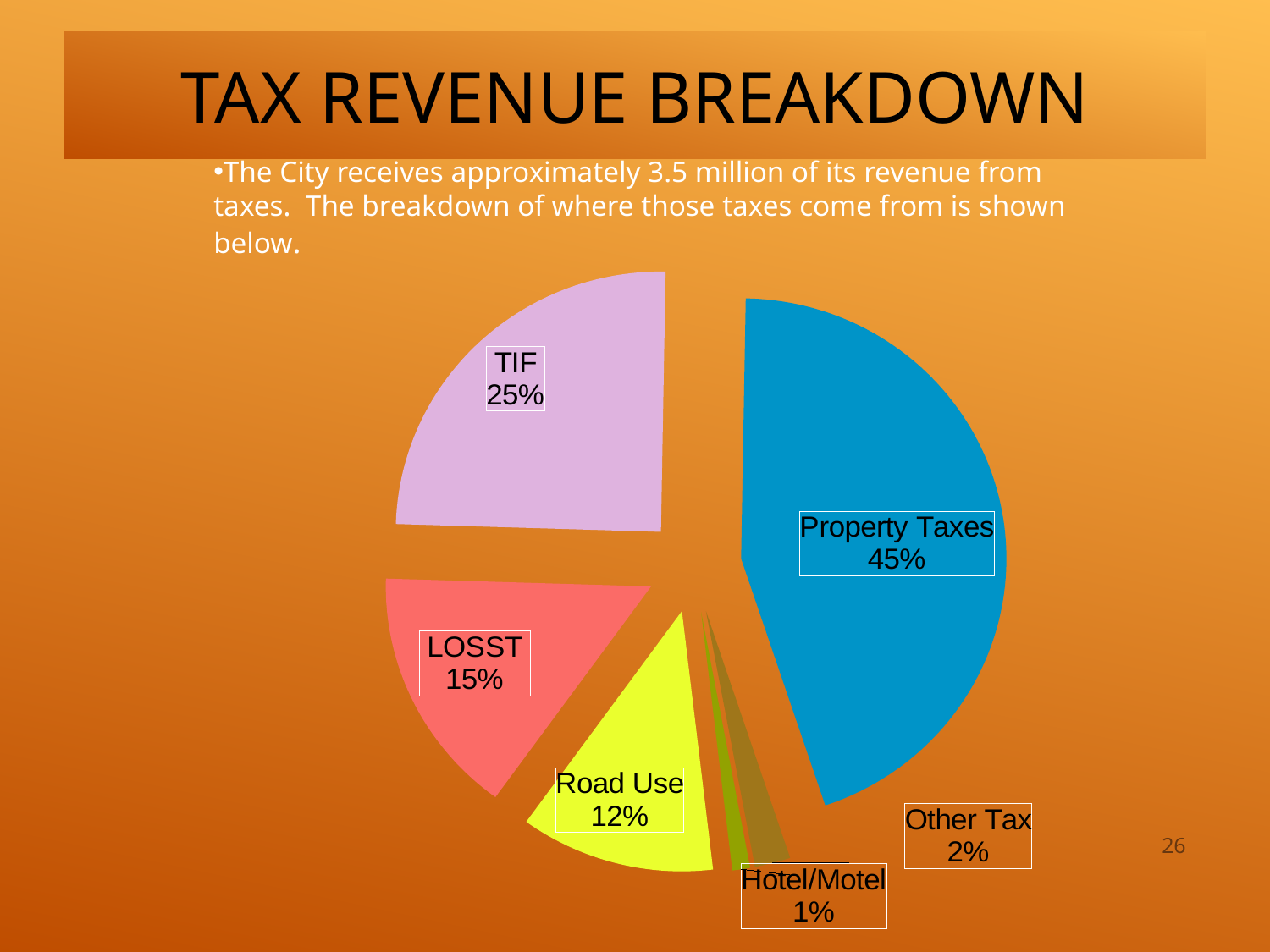
What share of tax revenue comes from LOSST? 15% What is the title of the slide containing the chart? TAX REVENUE BREAKDOWN What share of tax revenue comes from Property Taxes? 45% How many categories are shown in the pie chart? 6 What is the difference in percentage points between Property Taxes and TIF? 20 What share of tax revenue comes from Road Use? 12% Which category has the smallest share of tax revenue? Hotel/Motel What share of tax revenue comes from TIF? 25% What share of tax revenue comes from Hotel/Motel? 1% What kind of chart is shown on the slide? Pie chart Which category has the largest share of tax revenue? Property Taxes Which is larger, the LOSST share or the Road Use share? LOSST